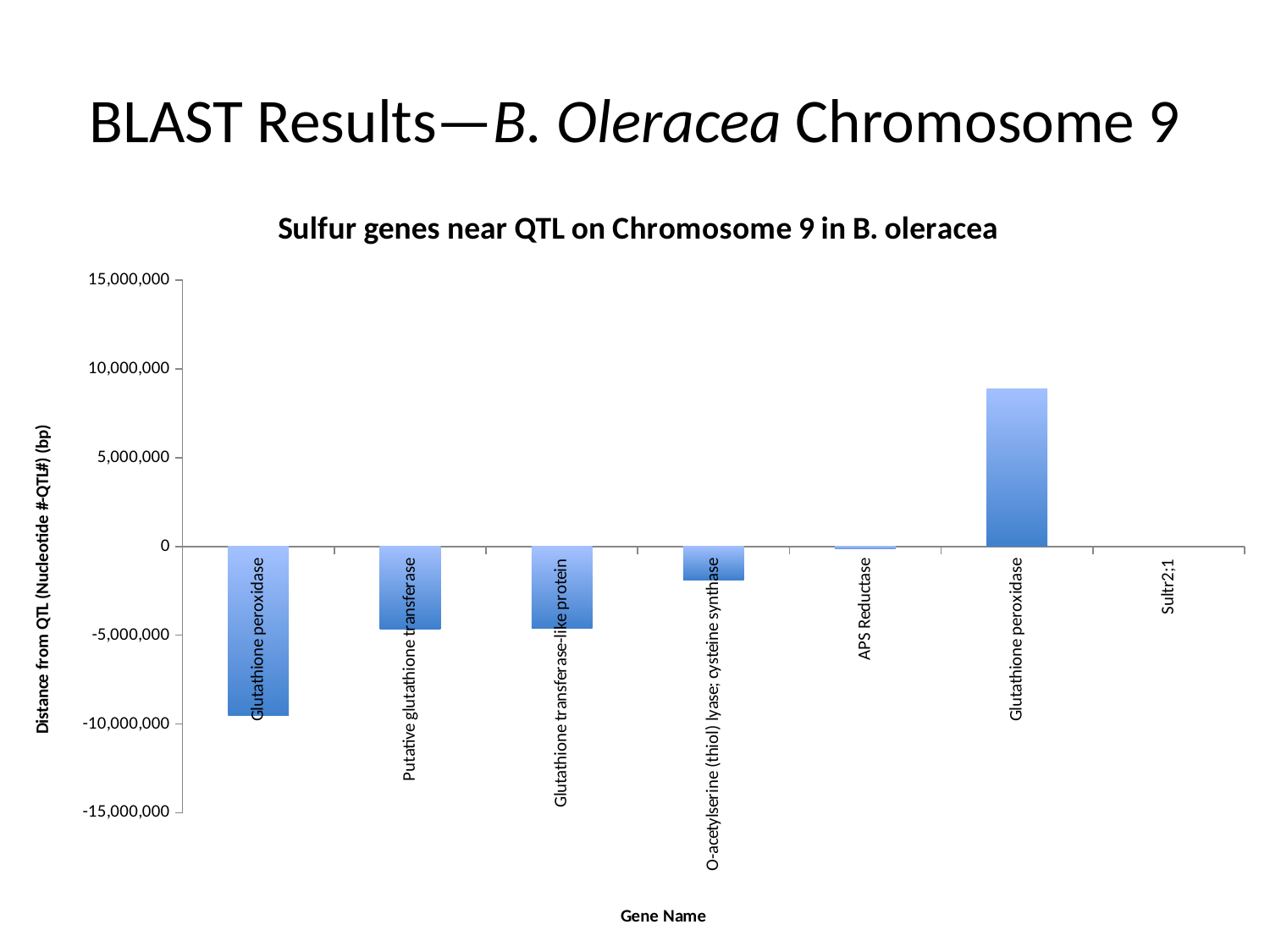
Is the value for O-acetylserine (thiol) lyase; cysteine synthase greater or less than -5,000,000? greater How many gene categories are plotted on the x axis? 7 Is the value for the first Glutathione peroxidase bar greater or less than -5,000,000? less What is the label of the y axis? Distance from QTL (Nucleotide #-QTL#) (bp) Which bar has the lowest value? Glutathione peroxidase (the first bar) What kind of chart is shown on the slide? bar chart Is the value for the sixth bar (Glutathione peroxidase) greater or less than 5,000,000? greater Which has the larger value, Putative glutathione transferase or O-acetylserine (thiol) lyase; cysteine synthase? O-acetylserine (thiol) lyase; cysteine synthase How many bars have a positive value? 1 Which bar has the highest value? Glutathione peroxidase (the sixth bar) What is the title of the chart? Sulfur genes near QTL on Chromosome 9 in B. oleracea